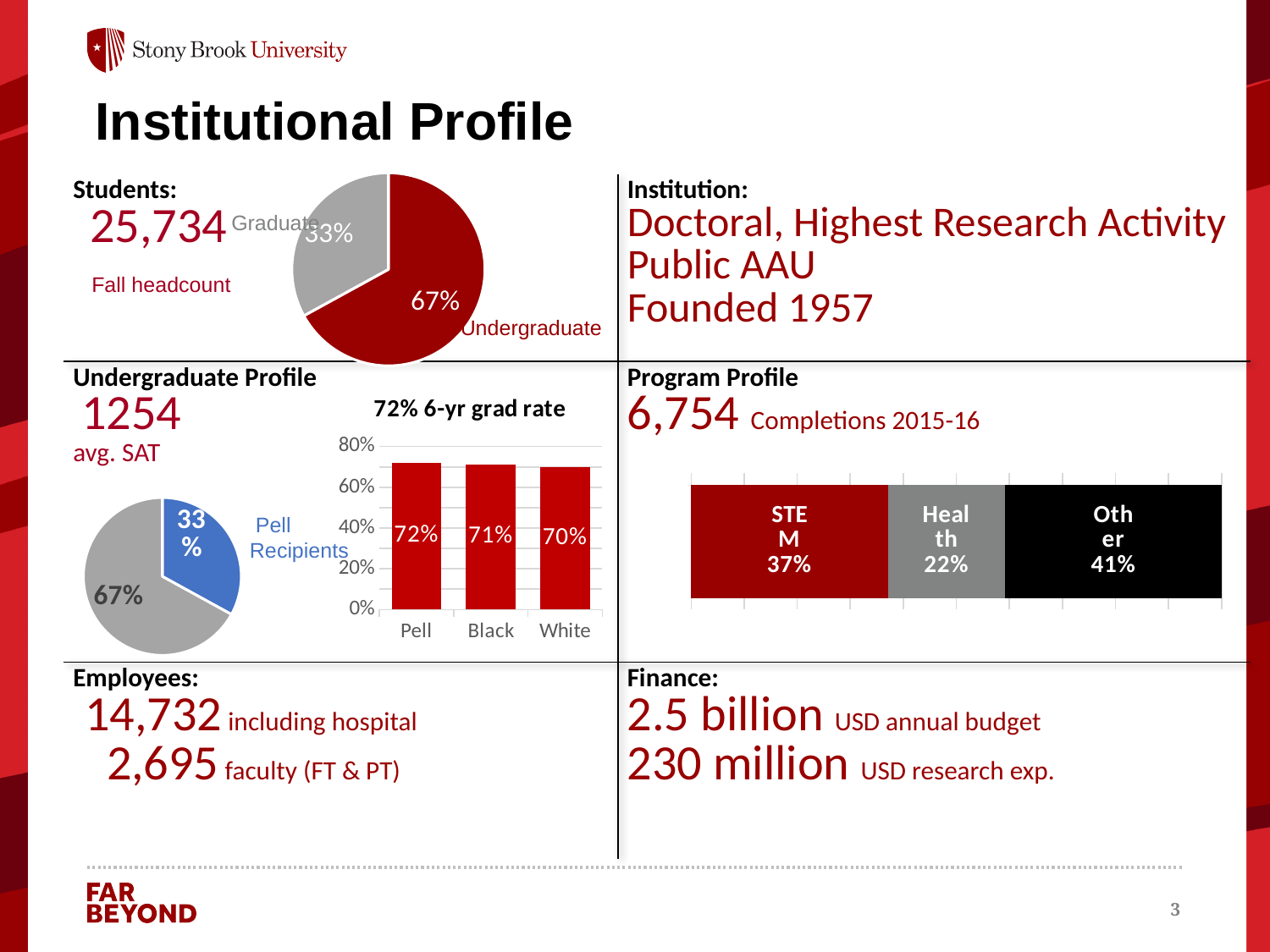
How many categories are shown in the '72% 6-yr grad rate' bar chart? 3 In the Students pie chart at the top left, what share is Undergraduate? 67% In the '72% 6-yr grad rate' bar chart, what is the value for White? 70% In the Program Profile stacked bar chart, what share is STEM? 37% In the Students pie chart at the top left, which slice is larger, Undergraduate or Graduate? Undergraduate What kind of chart is the '72% 6-yr grad rate' chart? Bar chart In the Students pie chart at the top left, what share is Graduate? 33% In the '72% 6-yr grad rate' bar chart, what is the value for Pell? 72% In the Pell Recipients pie chart in the Undergraduate Profile section, what share is Pell Recipients? 33% In the Program Profile stacked bar chart, which segment is the smallest? Health In the '72% 6-yr grad rate' bar chart, what is the difference between the Pell and White values? 2% In the '72% 6-yr grad rate' bar chart, which category has the lowest value? White